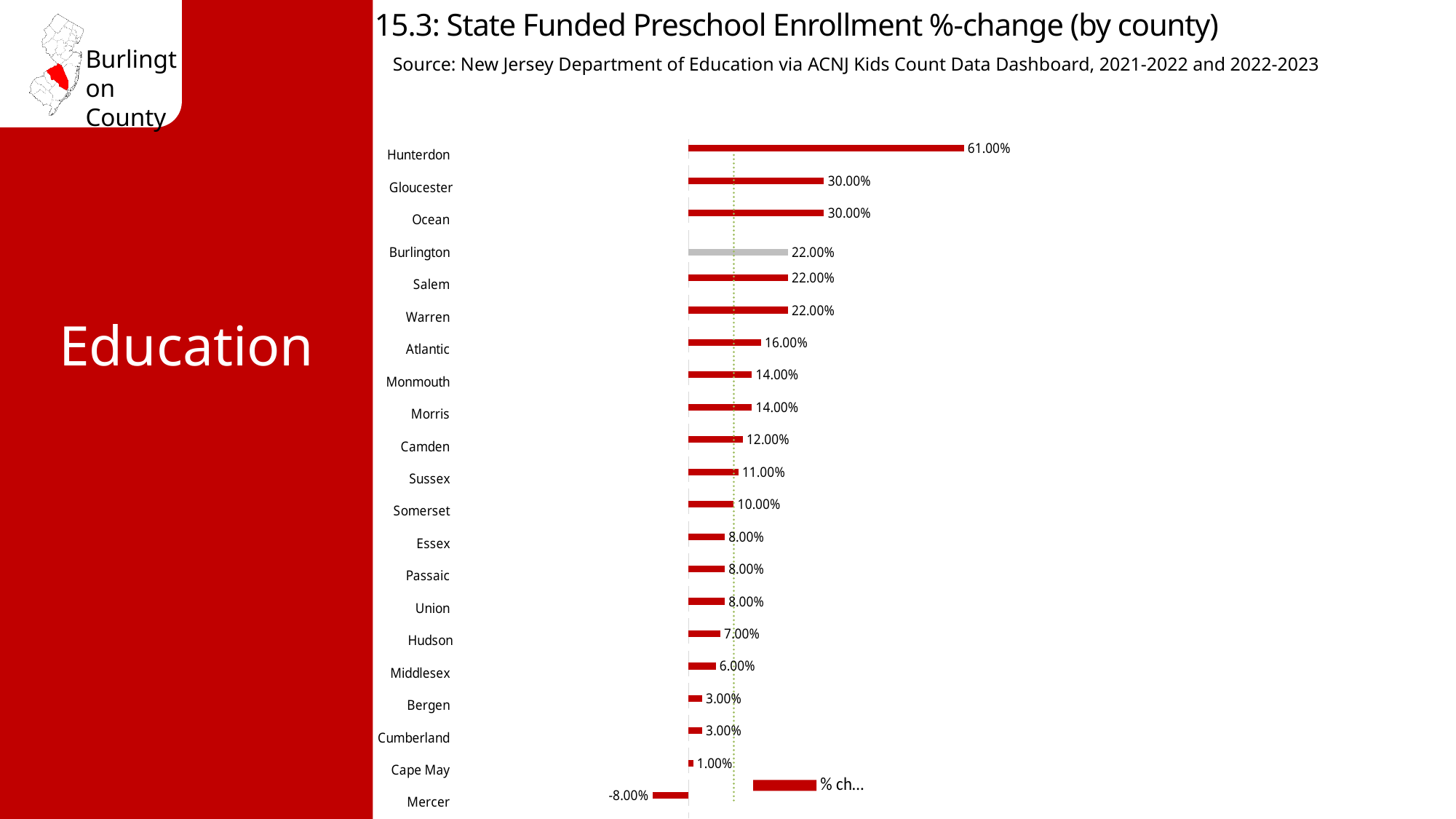
How many counties are shown in the chart? 21 What is the difference between the values for Burlington and Camden? 10.00% Which county has the highest value? Hunterdon Which is larger, the value for Ocean or the value for Salem? Ocean Which county's bar is coloured grey instead of red? Burlington What is the value for Hunterdon? 61.00% What is the difference between the values for Hunterdon and Gloucester? 31.00% What is the value for Burlington? 22.00% What kind of chart is shown on the slide? Bar chart What is the value for Mercer? -8.00% What is the value for Atlantic? 16.00% Which county has the lowest value? Mercer